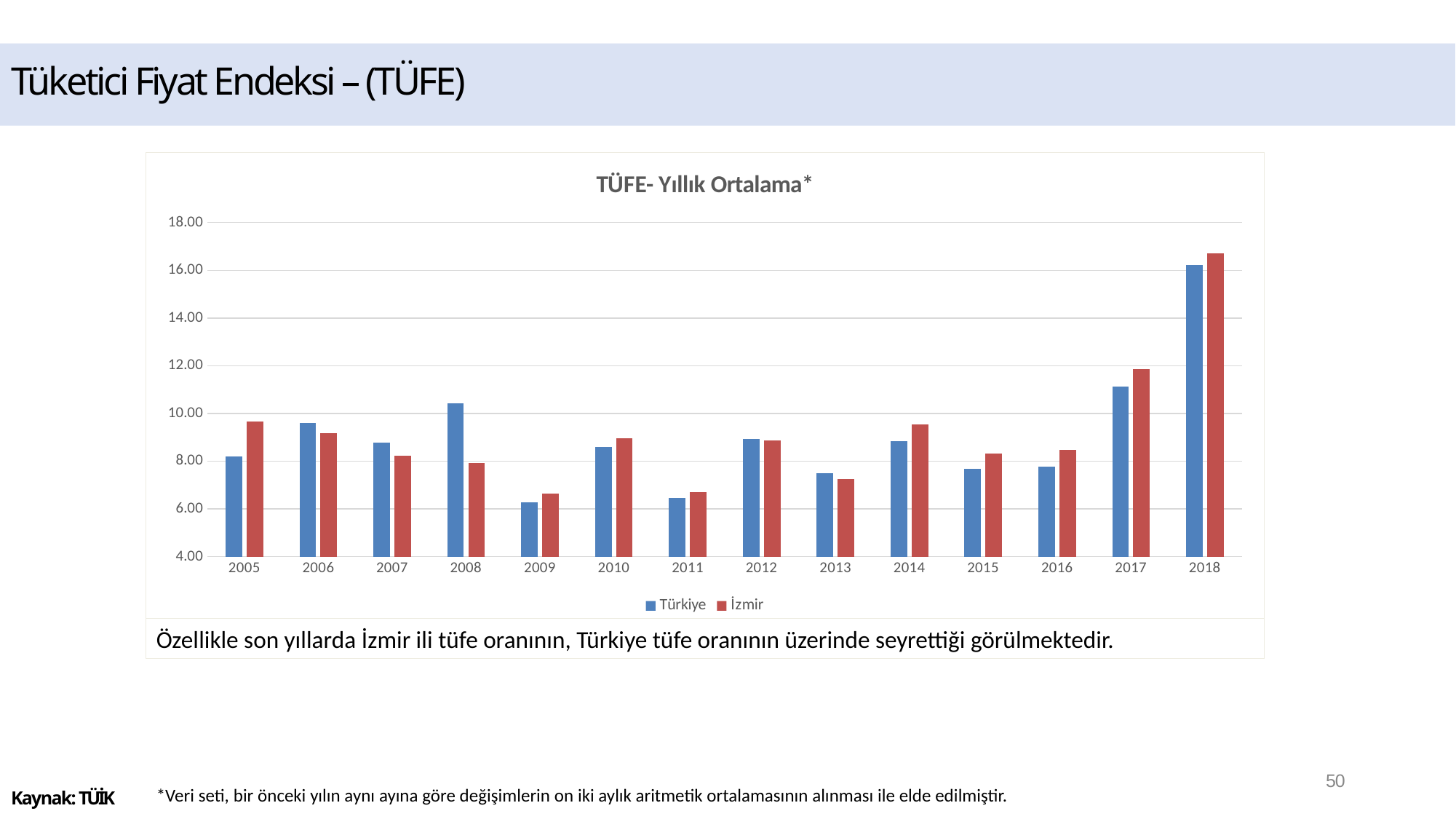
Do the Türkiye values rise or fall from 2016 to 2018? rise In 2008, which is larger, the Türkiye value or the İzmir value? Türkiye How many years are shown on the x axis of the chart? 14 Is the Türkiye value for 2008 greater or less than 10.00? greater In which year is the Türkiye value lowest? 2009 How many series does the legend of the chart list? 2 Is the Türkiye value for 2009 greater or less than 8.00? less What kind of chart is shown on the slide? bar chart In which year is the İzmir value highest? 2018 In 2005, which is larger, the Türkiye value or the İzmir value? İzmir In which year is the Türkiye value highest? 2018 Is the Türkiye value for 2018 greater or less than 14.00? greater